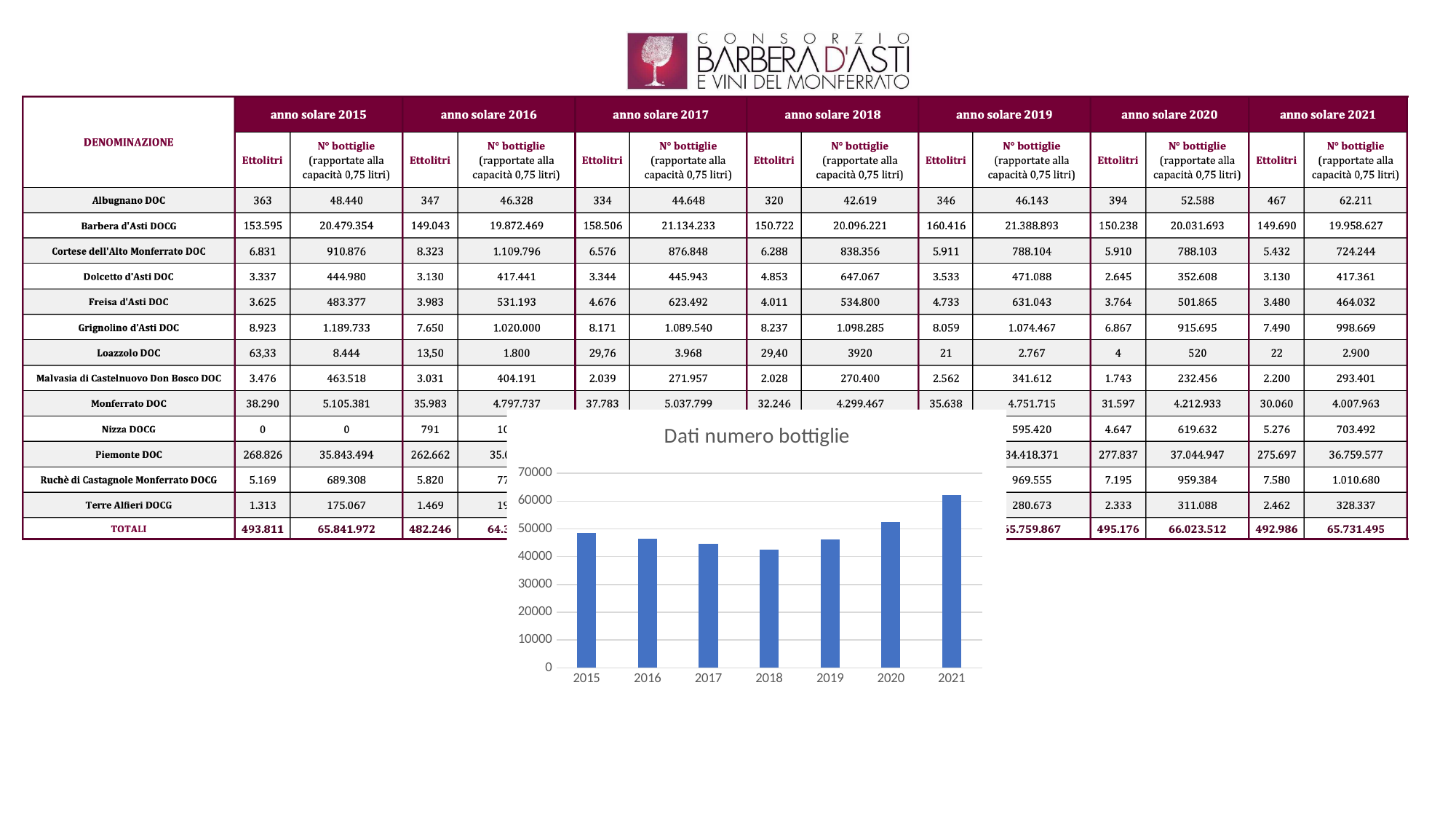
In the "Dati numero bottiglie" chart, is the value for 2015 greater or less than 40000? greater In the "Dati numero bottiglie" chart, which is larger, the value for 2020 or the value for 2017? 2020 In the "Dati numero bottiglie" chart, is the value for 2018 greater or less than 50000? less In the "Dati numero bottiglie" chart, do the values rise or fall from 2018 to 2021? rise What kind of chart is "Dati numero bottiglie"? bar chart In the "Dati numero bottiglie" chart, is the value for 2021 greater or less than 50000? greater In the "Dati numero bottiglie" chart, which year has the highest bar? 2021 In the "Dati numero bottiglie" chart, which is larger, the value for 2021 or the value for 2015? 2021 How many years are plotted in the "Dati numero bottiglie" chart? 7 In the "Dati numero bottiglie" chart, which year has the lowest bar? 2018 What is the title of the bar chart on the slide? Dati numero bottiglie